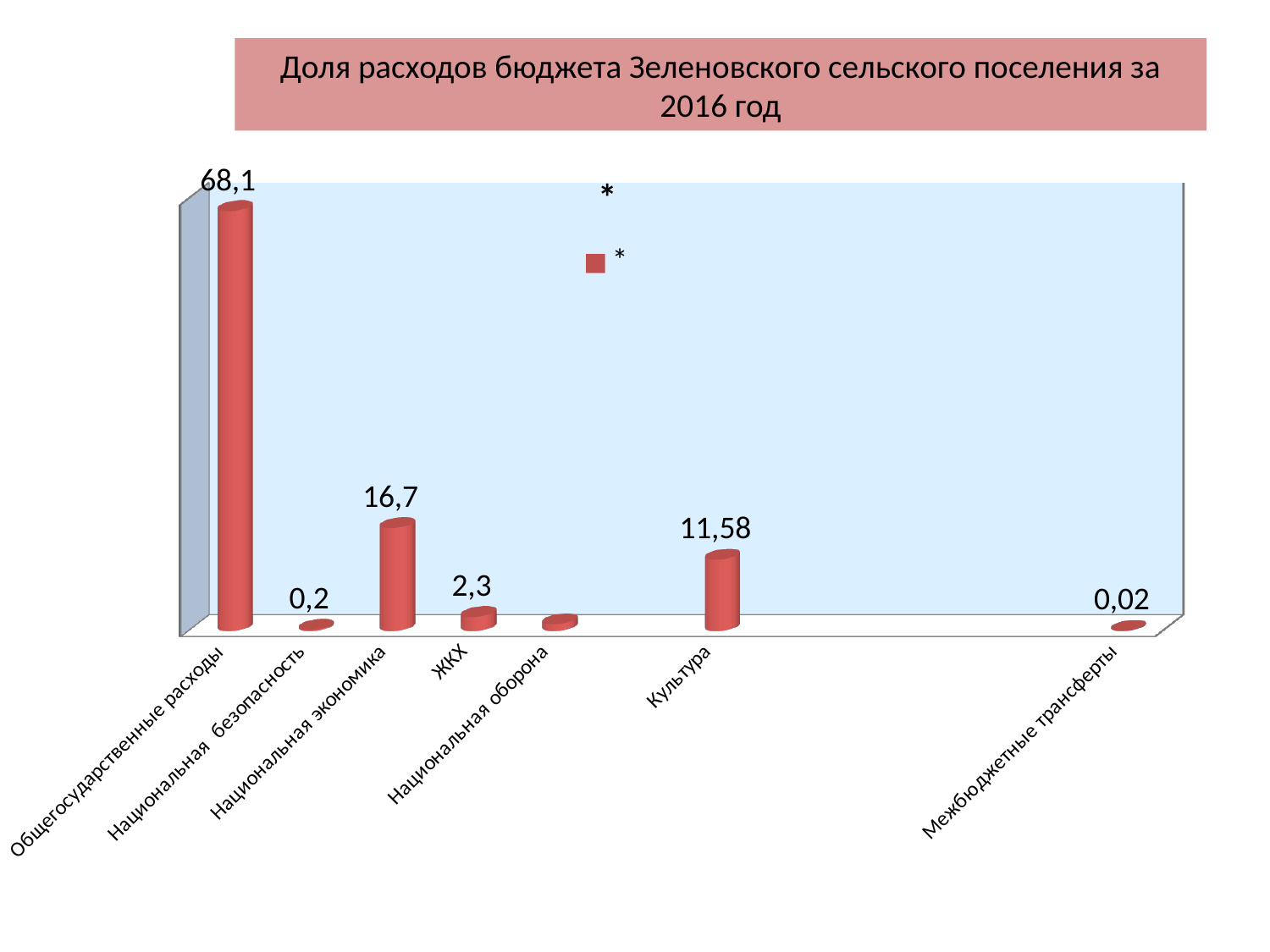
Which category has the highest value? Общегосударственные расходы What kind of chart is shown on the slide? Bar chart What is the value for Культура? 11,58 What is the value for Национальная экономика? 16,7 Which is larger, the value for Культура or the value for ЖКХ? Культура What is the value for Общегосударственные расходы? 68,1 What is the value for Межбюджетные трансферты? 0,02 What is the difference between the values for Национальная экономика and Культура? 5,12 Which category has the lowest value? Межбюджетные трансферты How many categories are shown on the x axis? 7 What is the difference between the values for Общегосударственные расходы and Национальная экономика? 51,4 What is the value for ЖКХ? 2,3